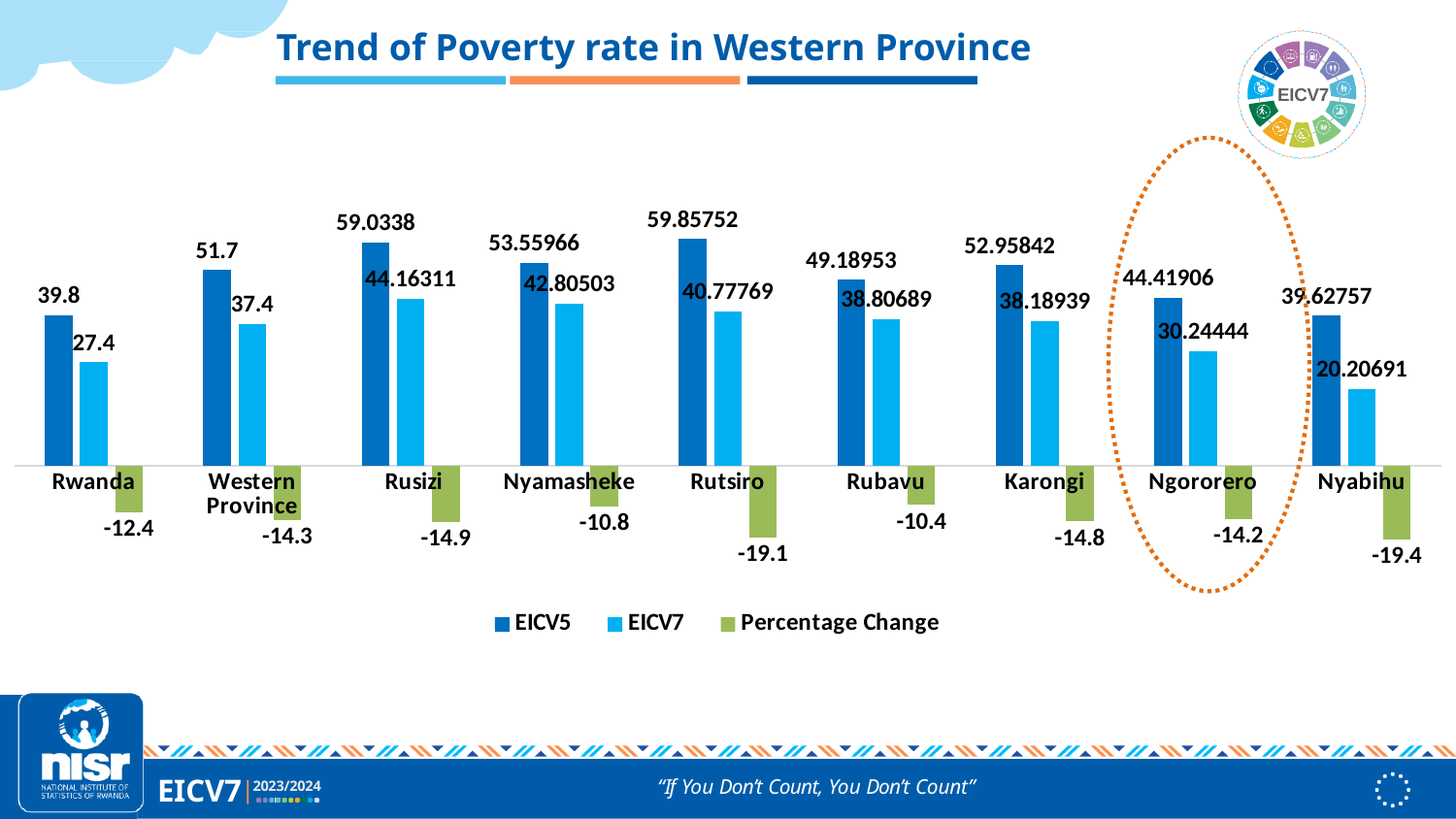
What kind of chart is shown on the slide? Bar chart Which is larger, the EICV7 poverty rate for Rusizi or for Nyamasheke? Rusizi What is the title of the chart? Trend of Poverty rate in Western Province Which category has the highest EICV5 poverty rate? Rutsiro What is the Percentage Change value for Rutsiro? -19.1 Which category has the lowest EICV7 poverty rate? Nyabihu How many categories are shown on the x axis? 9 What is the difference between the EICV5 and EICV7 poverty rates for Rwanda? 12.4 What is the EICV7 poverty rate for Nyabihu? 20.20691 Which category has the largest negative Percentage Change? Nyabihu What is the EICV5 poverty rate for Rusizi? 59.0338 How many series does the legend list? 3